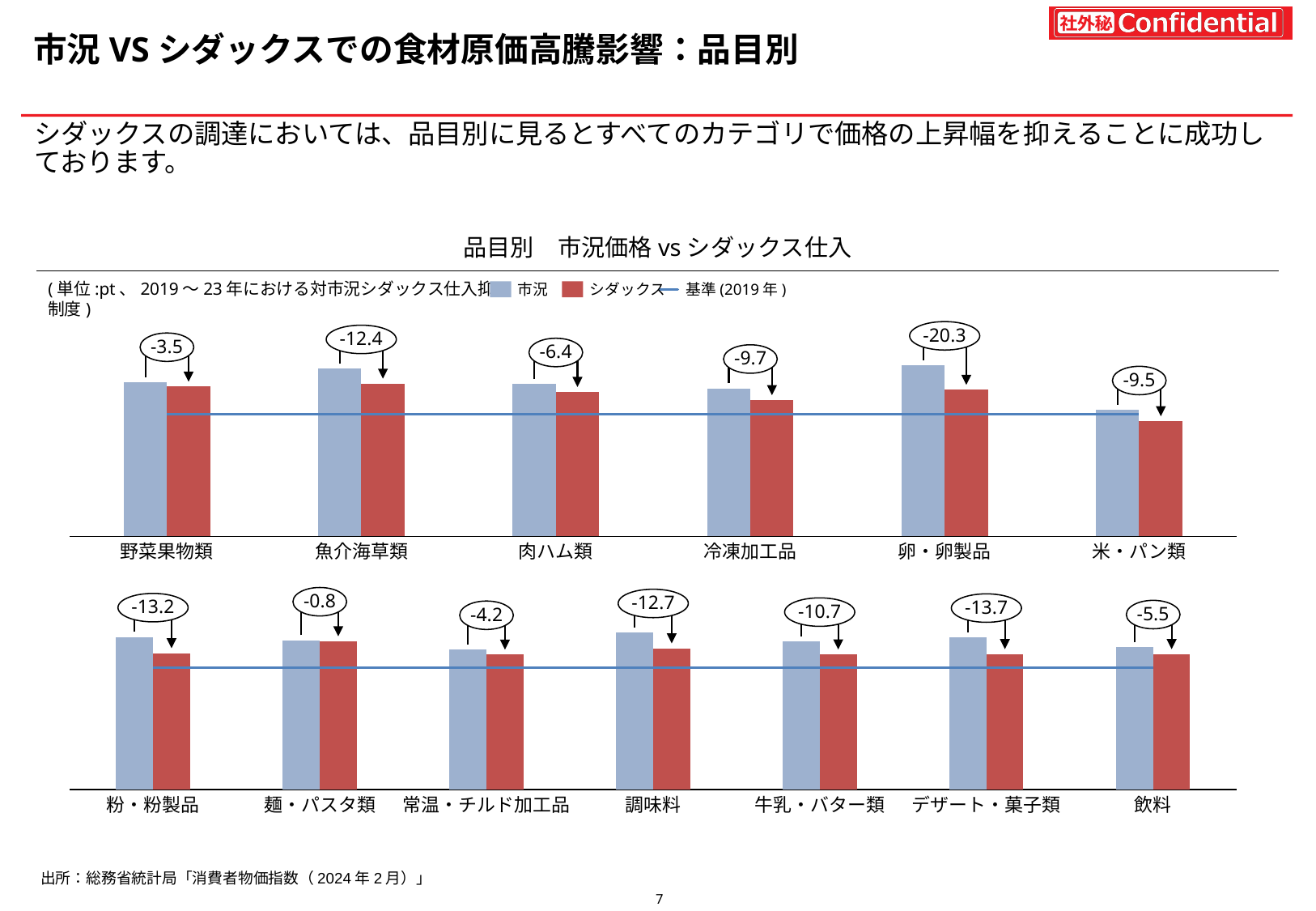
How many entries does the legend list? 3 How many categories are shown in the bottom chart? 7 In the bottom chart, which category has the largest labelled reduction (most negative value)? デザート・菓子類 What type of chart is used on this slide? Bar chart In the top chart, which bar is taller for 卵・卵製品, 市況 or シダックス? 市況 In the top chart, what is the labelled difference for 魚介海草類? -12.4 How many categories are shown in the top chart? 6 In the bottom chart, what is the labelled difference for 調味料? -12.7 In the top chart, which category has the largest labelled reduction (most negative value)? 卵・卵製品 In the bottom chart, what is the labelled difference for 麺・パスタ類? -0.8 In the bottom chart, which category has the smallest labelled reduction (closest to zero)? 麺・パスタ類 In the top chart, what is the labelled difference for 卵・卵製品? -20.3